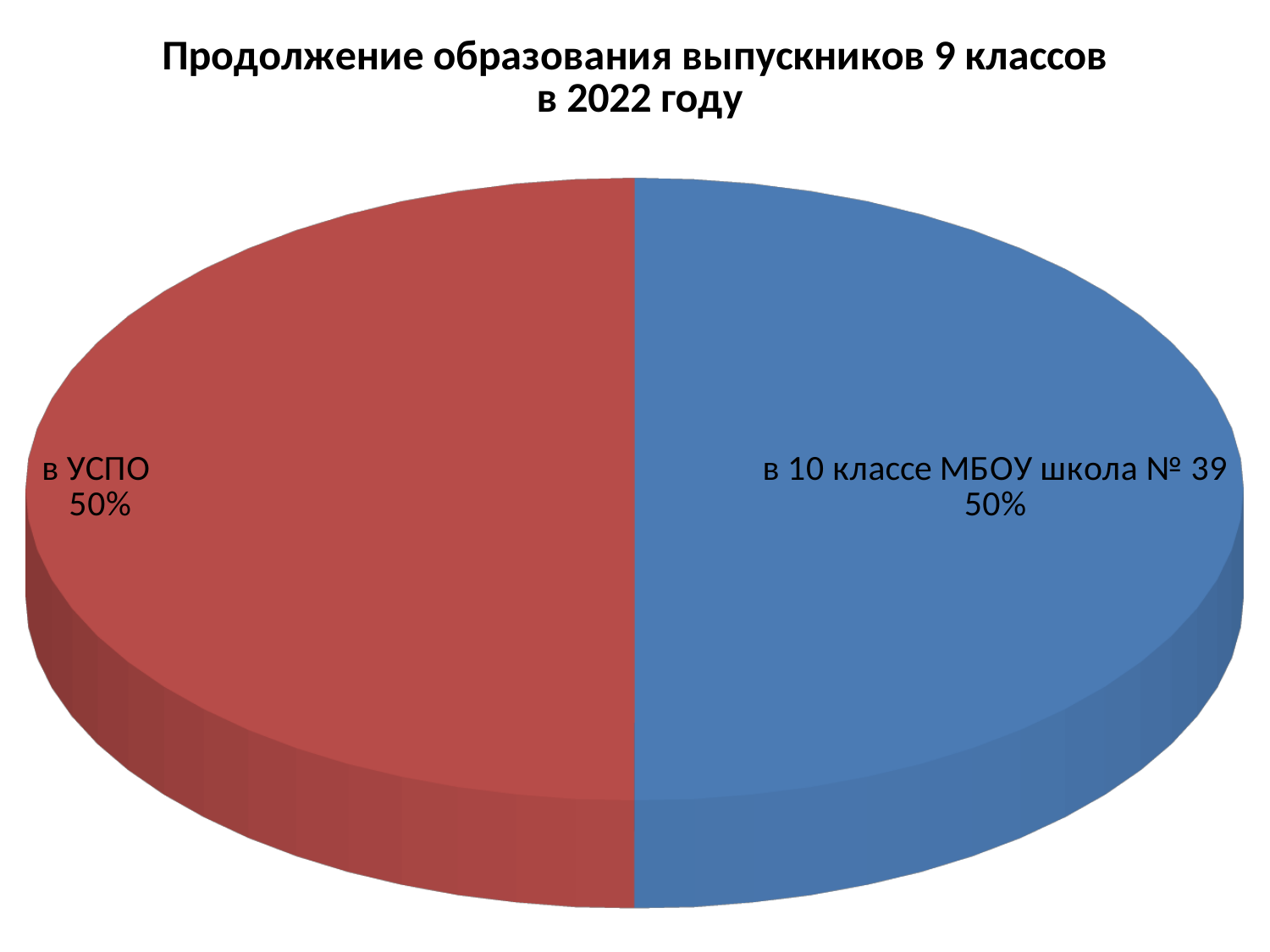
What colour is the slice for "в УСПО"? red What is the title of the chart? Продолжение образования выпускников 9 классов в 2022 году What kind of chart is shown on the slide? pie chart What is the difference between the shares of "в УСПО" and "в 10 классе МБОУ школа № 39"? 0% What share of the pie does the slice "в УСПО" represent? 50% What share of the pie does the slice "в 10 классе МБОУ школа № 39" represent? 50% How many slices does the pie chart have? 2 Is the share for "в 10 классе МБОУ школа № 39" greater than, less than, or equal to the share for "в УСПО"? equal What is the total of the two slices shown in the pie chart? 100%